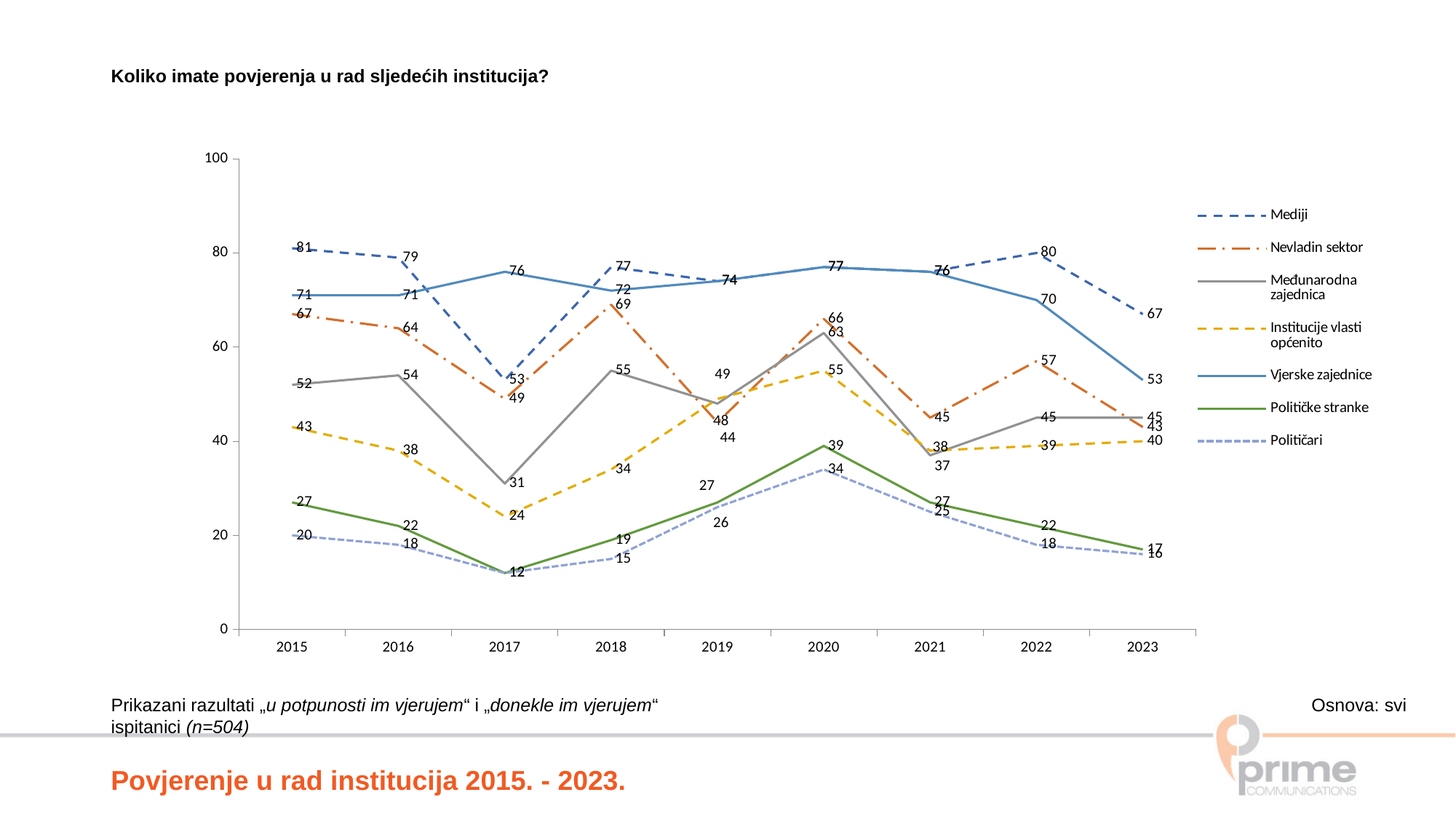
What question is shown as the chart's title at the top of the slide? Koliko imate povjerenja u rad sljedećih institucija? By how much did the value for Mediji fall from 2022 to 2023? 13 What is the value for Političari in 2020? 34 How many series does the legend list? 7 What is the value for Vjerske zajednice in 2023? 53 In which year is the value for Političke stranke lowest? 2017 In which year is the value for Mediji highest? 2015 What kind of chart is shown on the slide? line chart In 2023, which is larger: the value for Mediji or the value for Vjerske zajednice? Mediji Does the value for Vjerske zajednice rise or fall from 2020 to 2023? fall How many years are shown on the x axis? 9 What is the value for Mediji in 2015? 81